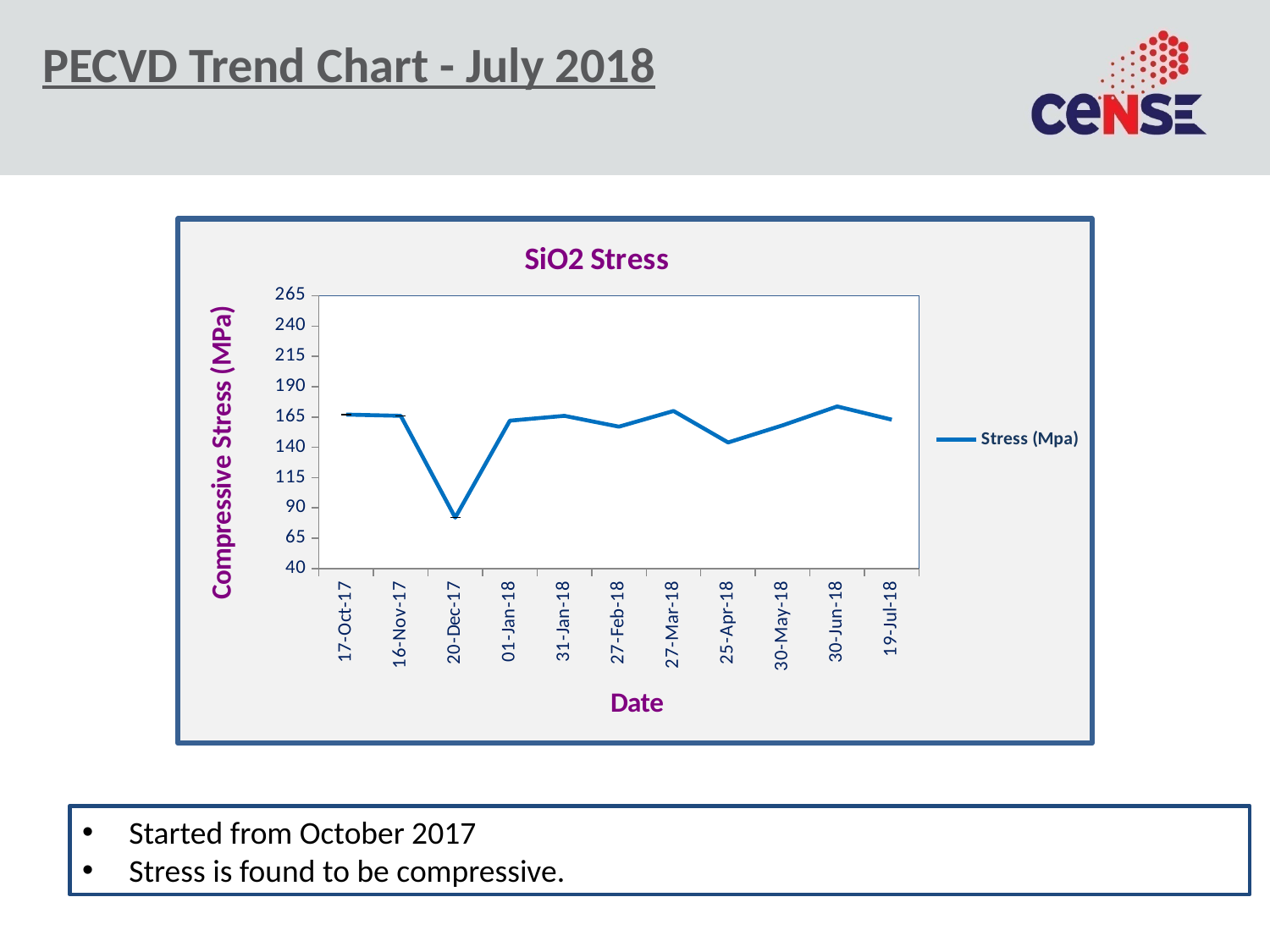
Does the stress value rise or fall from 16-Nov-17 to 20-Dec-17? Fall Which has the larger stress value, 25-Apr-18 or 30-Jun-18? 30-Jun-18 Is the value for 30-Jun-18 greater or less than 140? greater How many series does the legend list? 1 Is the value for 25-Apr-18 greater or less than 165? less What kind of chart is shown on the slide? Line chart Is the value for 20-Dec-17 greater or less than 115? less What is the title of the chart? SiO2 Stress How many dates are labelled along the x axis? 11 On which date is the stress value lowest? 20-Dec-17 What is the name of the series shown in the legend? Stress (Mpa) Which has the larger stress value, 20-Dec-17 or 01-Jan-18? 01-Jan-18